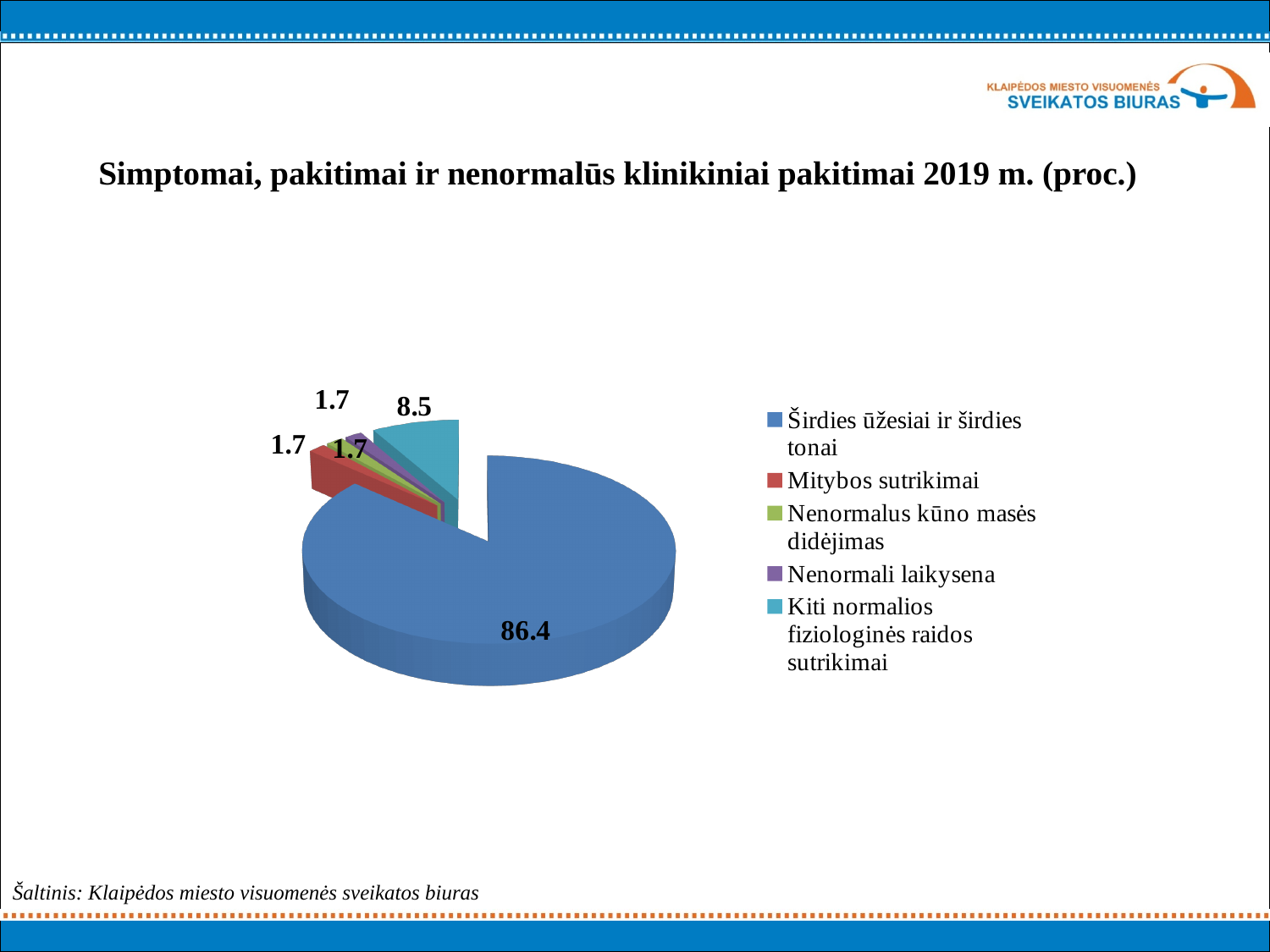
What is the value for Kiti normalios fiziologinės raidos sutrikimai in the pie chart? 8.5 What is the difference between the values for Kiti normalios fiziologinės raidos sutrikimai and Nenormalus kūno masės didėjimas? 6.8 What is the value for Mitybos sutrikimai in the pie chart? 1.7 Which is larger: the value for Kiti normalios fiziologinės raidos sutrikimai or the value for Mitybos sutrikimai? Kiti normalios fiziologinės raidos sutrikimai What is the difference between the values for Širdies ūžesiai ir širdies tonai and Kiti normalios fiziologinės raidos sutrikimai? 77.9 What is the value for Širdies ūžesiai ir širdies tonai in the pie chart? 86.4 What is the value for Nenormali laikysena in the pie chart? 1.7 What kind of chart is shown on the slide? Pie chart How many categories are shown in the pie chart? 5 Which category has the largest slice in the pie chart? Širdies ūžesiai ir širdies tonai What colour is the slice for Širdies ūžesiai ir širdies tonai? Blue What is the title of the chart on the slide? Simptomai, pakitimai ir nenormalūs klinikiniai pakitimai 2019 m. (proc.)